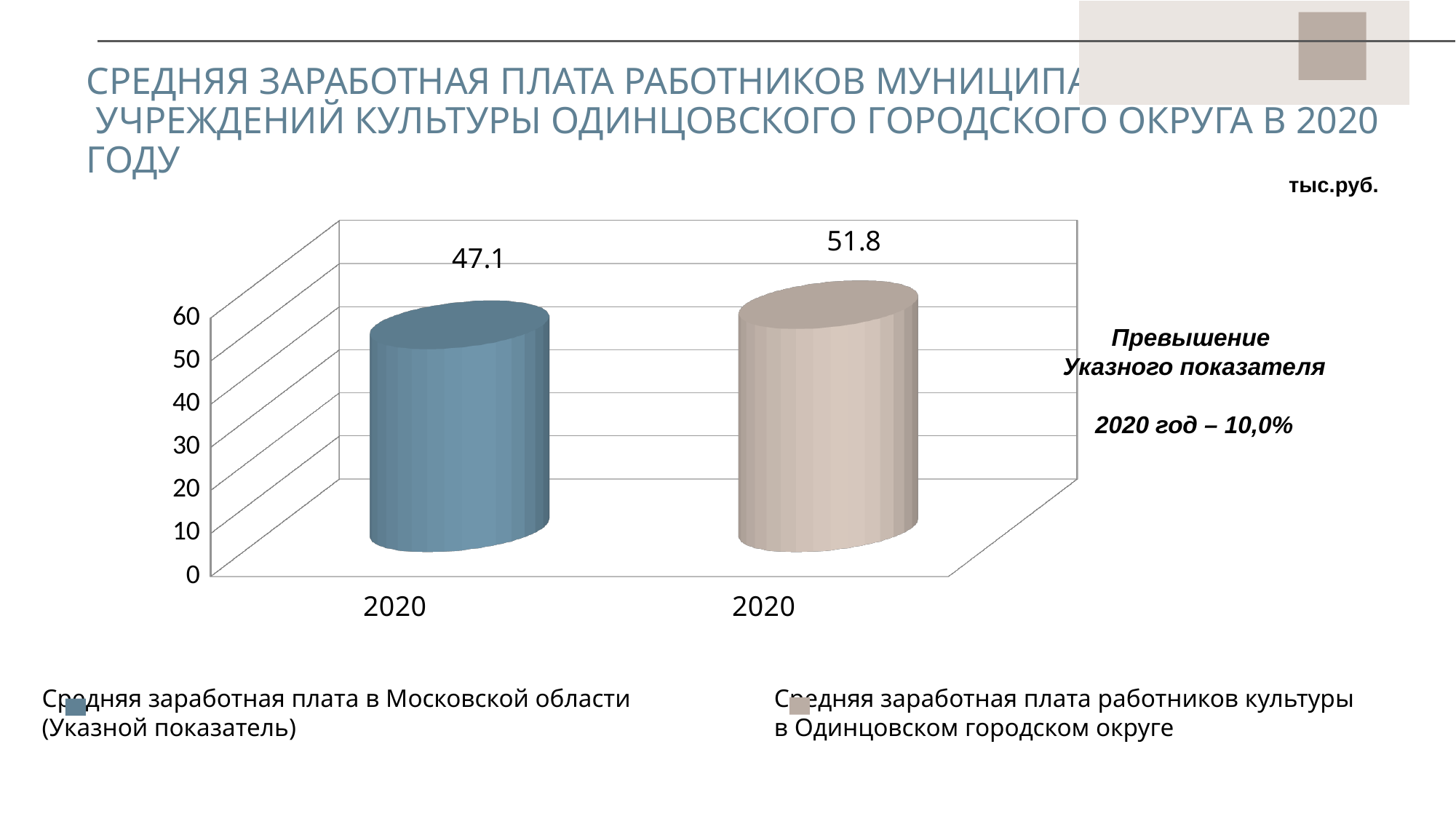
Which bar shows the lowest value on the chart? Средняя заработная плата в Московской области (Указной показатель) What is the highest tick value shown on the vertical axis? 60 How many series does the legend list? 2 What is the difference between the Odintsovo culture workers' salary (51.8) and the Moscow region indicator (47.1)? 4.7 What type of chart is shown on the slide? bar chart What unit of measurement is indicated for the chart values? тыс.руб. Is the value for the Moscow region average salary greater or less than 50? less Which series has the higher value: the Moscow region average salary or the Odintsovo culture workers' average salary? Средняя заработная плата работников культуры в Одинцовском городском округе Is the value for the Odintsovo culture workers' average salary greater or less than 50? greater What is the value shown for the average salary of culture workers in the Odintsovo city district? 51.8 What is the value shown for the average salary in the Moscow region (Указной показатель)? 47.1 How many bars are plotted on the chart? 2